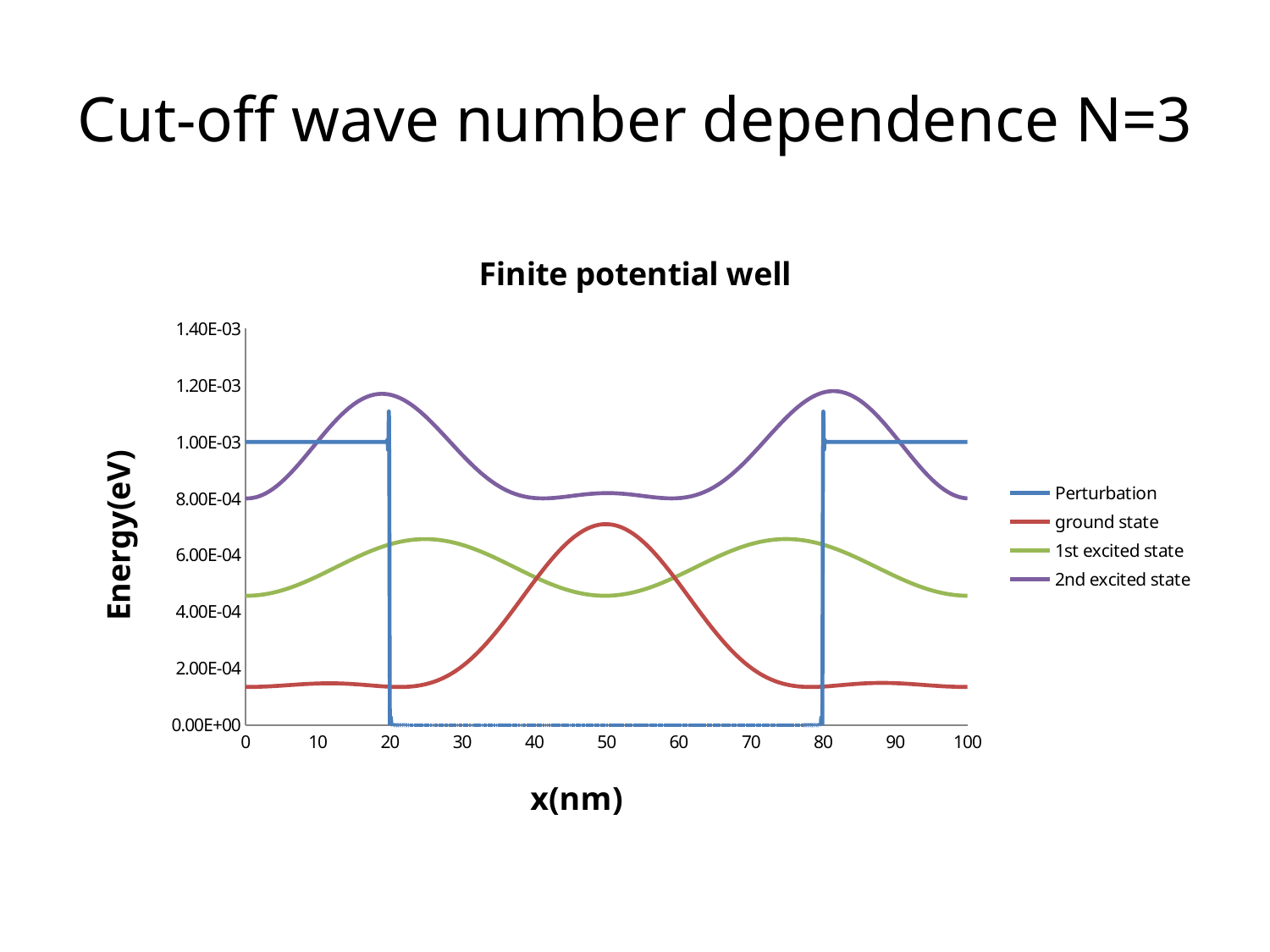
What is the value of the Perturbation series at x = 10 nm? 1.00E-03 Which series has the lowest value at x = 50 nm? Perturbation What is the title of the chart? Finite potential well Is the value of the ground state at x = 50 nm greater or less than 6.00E-04? greater Is the value of the 2nd excited state at x = 50 nm greater or less than 1.00E-03? less What is the value of the Perturbation series at x = 50 nm? 0.00E+00 At x = 50 nm, which is larger: the ground state or the 1st excited state? ground state How many series does the legend list? 4 What type of chart is shown on the slide? line chart Is the value of the 1st excited state at x = 0 nm greater or less than 6.00E-04? less Which series has the highest value at x = 50 nm? 2nd excited state What is the label of the y axis? Energy(eV)